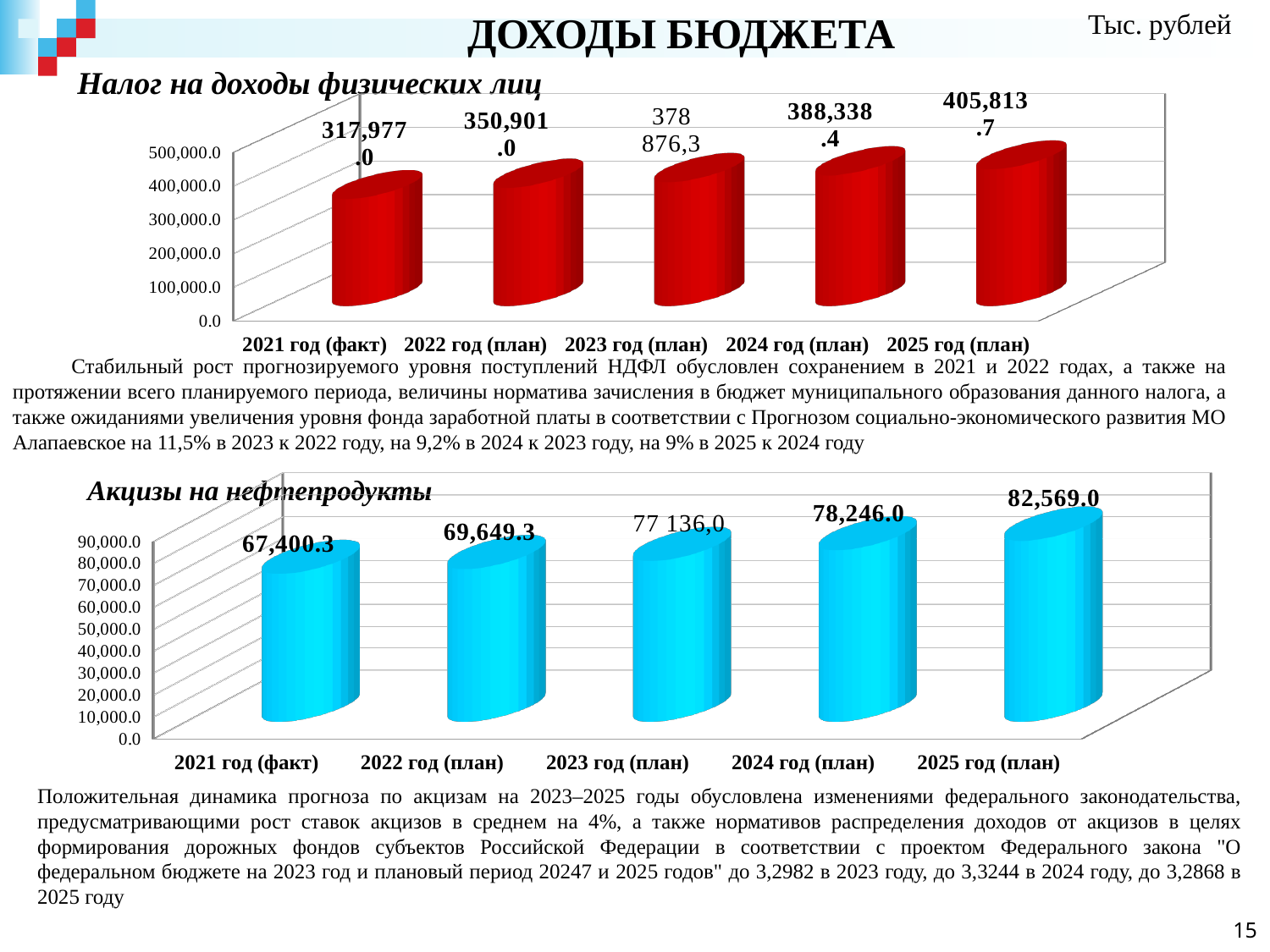
On the chart 'Акцизы на нефтепродукты', what is the value for 2024 год (план)? 78,246.0 On the chart 'Акцизы на нефтепродукты', what is the difference between the 2025 год (план) and 2024 год (план) values? 4,323.0 On the chart 'Налог на доходы физических лиц', do the values rise or fall from 2021 to 2025? rise On the chart 'Акцизы на нефтепродукты', which is larger: the value for 2021 год (факт) or 2023 год (план)? 2023 год (план) On the chart 'Налог на доходы физических лиц', what is the value for 2021 год (факт)? 317,977.0 On the chart 'Акцизы на нефтепродукты', which year has the highest value? 2025 год (план) On the chart 'Налог на доходы физических лиц', how many bars are plotted? 5 On the chart 'Налог на доходы физических лиц', which year has the lowest value? 2021 год (факт) On the chart 'Акцизы на нефтепродукты', what is the value for 2022 год (план)? 69,649.3 On the chart 'Налог на доходы физических лиц', what is the value for 2025 год (план)? 405,813.7 What type of chart is 'Акцизы на нефтепродукты'? bar chart On the chart 'Налог на доходы физических лиц', what is the difference between the 2022 год (план) and 2021 год (факт) values? 32,924.0